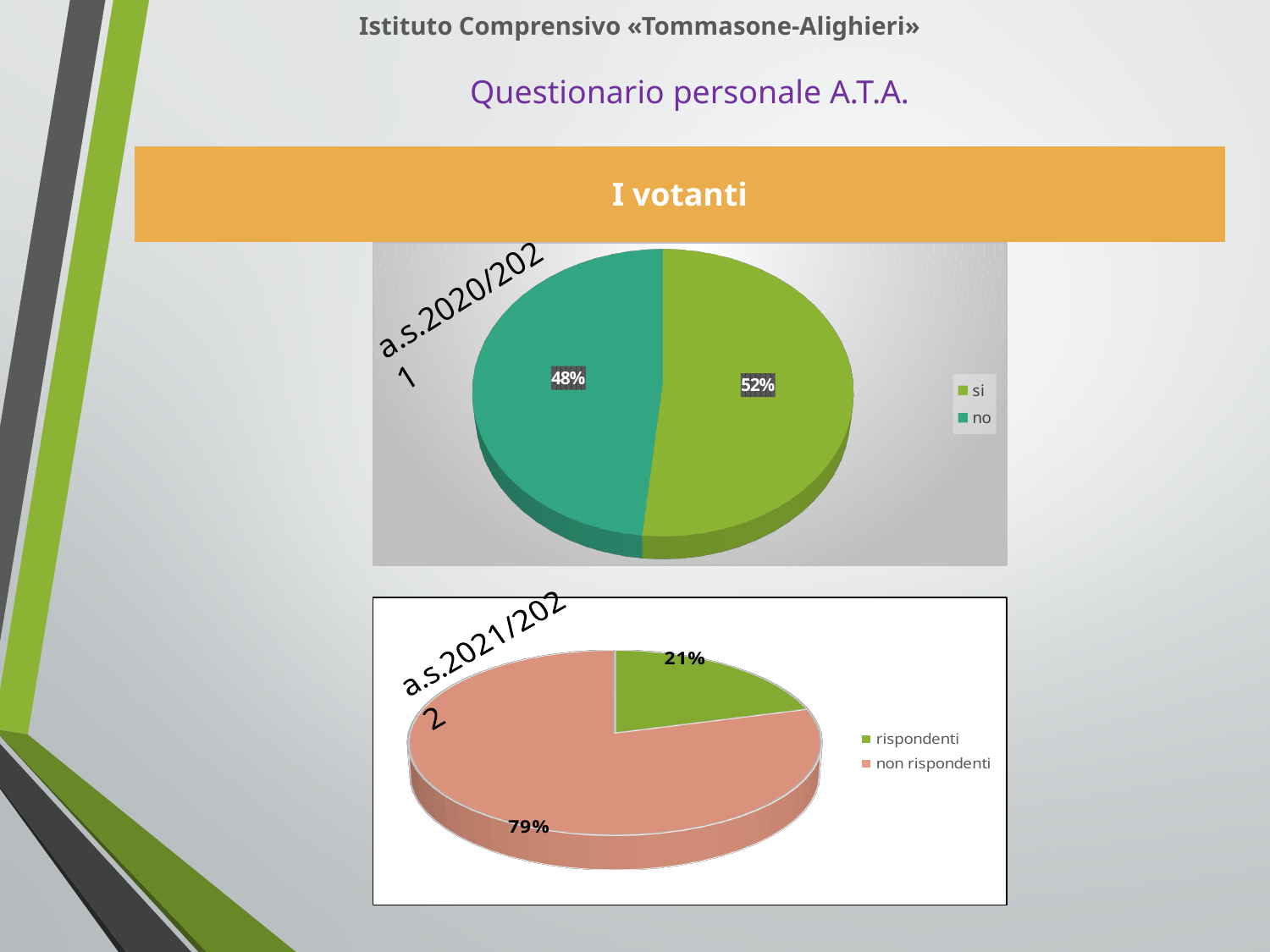
In the bottom chart (a.s.2021/2022), what is the difference between "non rispondenti" and "rispondenti"? 58% In the top chart (a.s.2020/2021), what is the difference between "si" and "no"? 4% What kind of chart is the top chart (a.s.2020/2021)? pie chart In the bottom chart (a.s.2021/2022), what is the value for "rispondenti"? 21% In the bottom chart (a.s.2021/2022), what is the value for "non rispondenti"? 79% What colour is the "non rispondenti" slice in the bottom chart (a.s.2021/2022)? salmon pink How many slices does the bottom chart (a.s.2021/2022) have? 2 In the top chart (a.s.2020/2021), what is the value for "no"? 48% How many entries does the legend of the top chart (a.s.2020/2021) list? 2 In the top chart (a.s.2020/2021), which slice is larger, "si" or "no"? si In the top chart (a.s.2020/2021), what is the value for "si"? 52% In the bottom chart (a.s.2021/2022), which category has the largest slice? non rispondenti